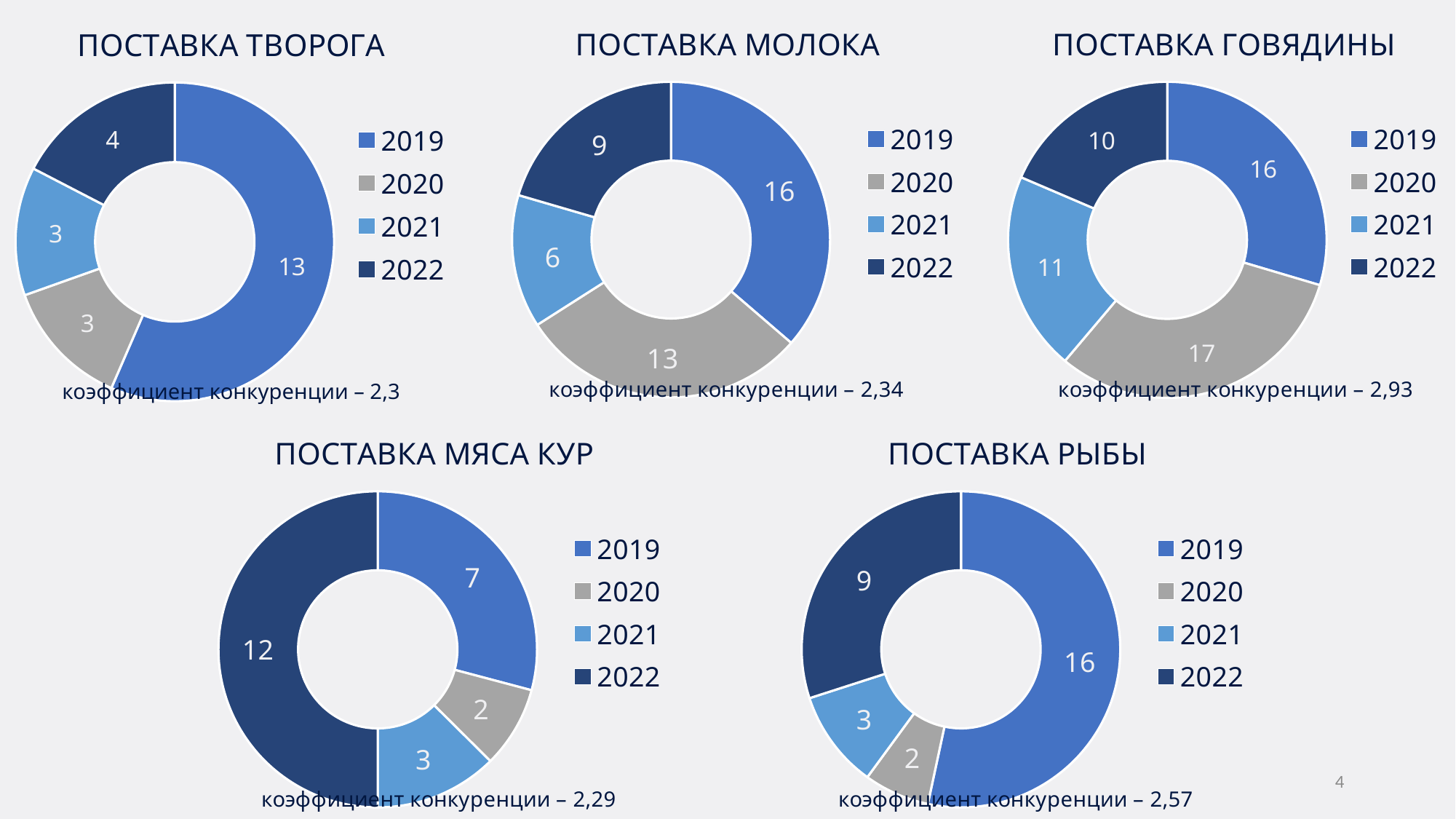
How many slices does the ПОСТАВКА ГОВЯДИНЫ chart have? 4 What competition coefficient (коэффициент конкуренции) is shown under the ПОСТАВКА ГОВЯДИНЫ chart? 2,93 What kind of chart is ПОСТАВКА МЯСА КУР? Doughnut chart In the ПОСТАВКА МЯСА КУР chart, what share of the total does 2022 represent? 50% In the ПОСТАВКА МОЛОКА chart, what is the value for 2020? 13 In the ПОСТАВКА ТВОРОГА chart, what is the value for 2019? 13 In the ПОСТАВКА РЫБЫ chart, what is the difference between the values for 2019 and 2022? 7 In the ПОСТАВКА ГОВЯДИНЫ chart, which year has the highest value? 2020 In the ПОСТАВКА МОЛОКА chart, which is larger: the value for 2021 or the value for 2022? 2022 How many entries does the legend of the ПОСТАВКА РЫБЫ chart list? 4 What is the total of all slices in the ПОСТАВКА ТВОРОГА chart? 23 In the ПОСТАВКА МЯСА КУР chart, which year has the lowest value? 2020